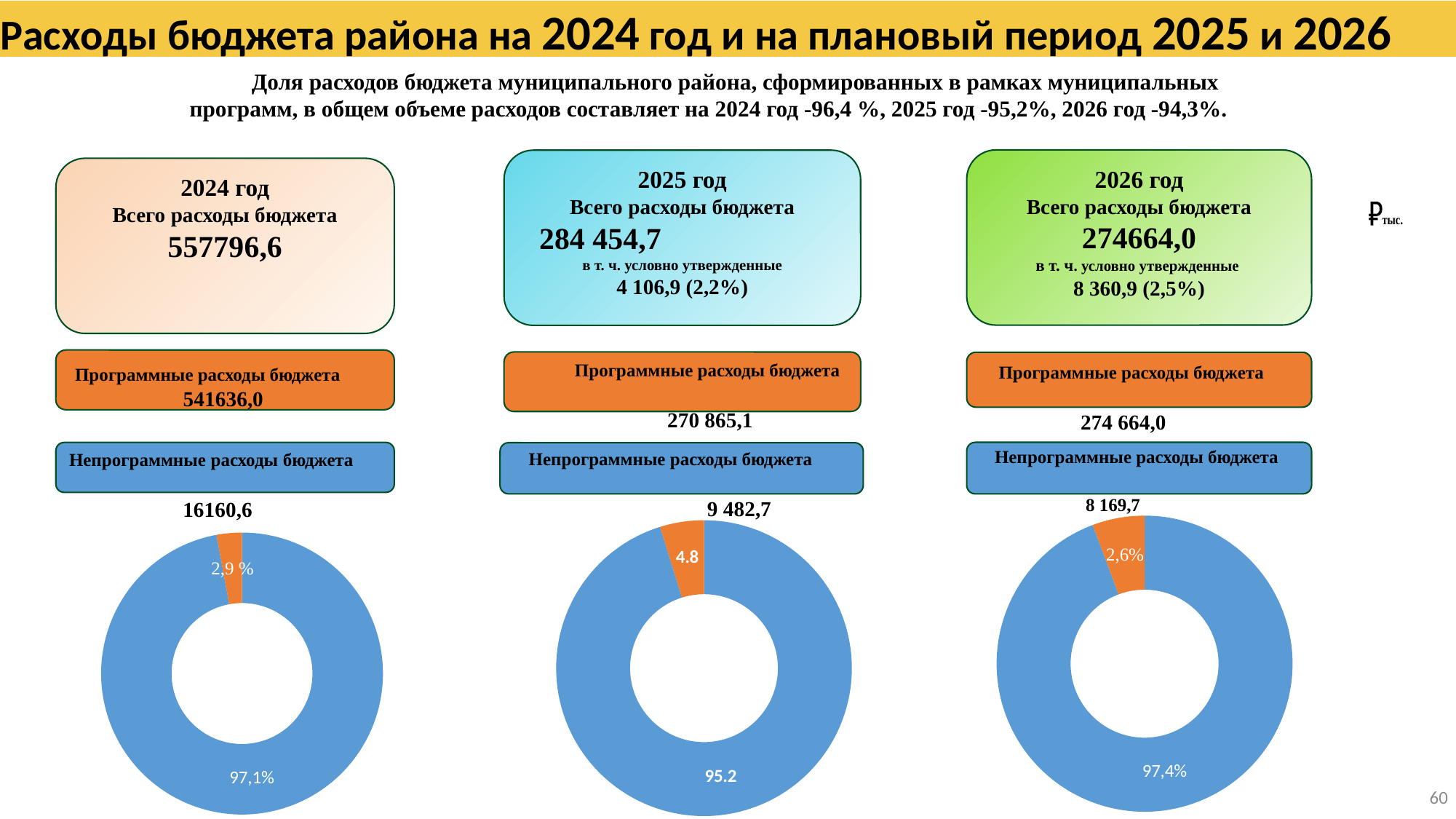
In the left doughnut chart (2024), which slice is larger, the blue one or the orange one? The blue one How many slices does each doughnut chart on the slide have? 2 What colour is the slice representing the larger share in each doughnut chart? Blue In the right doughnut chart (2026), what percentage is shown on the blue slice? 97,4% What kind of chart is shown at the bottom left of the slide (under 2024)? Doughnut (pie) chart In the middle doughnut chart (2025), what value is shown on the blue slice? 95.2 In the middle doughnut chart (2025), what value is shown on the orange slice? 4.8 In the left doughnut chart (2024), what percentage is shown on the large blue slice? 97,1% In the right doughnut chart (2026), what percentage is shown on the orange slice? 2,6% In the left doughnut chart (2024), what percentage is shown on the small orange slice? 2,9 %